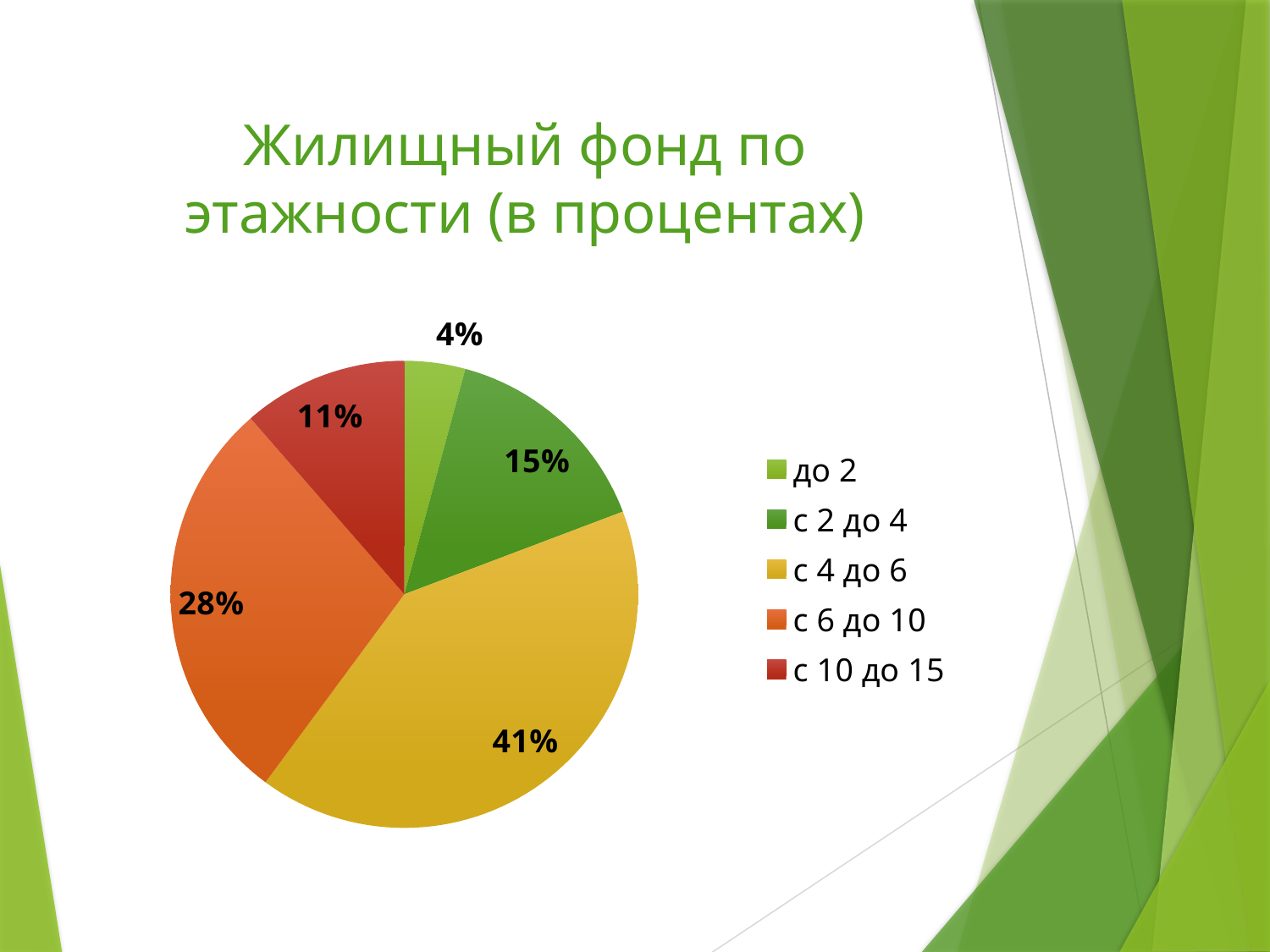
Which category has the smallest share of the pie? до 2 What colour is the "с 6 до 10" slice? orange What kind of chart is shown on the slide? pie chart What is the difference between the "с 4 до 6" and "с 6 до 10" slices? 13% Which category has the largest share of the pie? с 4 до 6 What is the value for the "с 10 до 15" slice? 11% What is the title of the chart? Жилищный фонд по этажности (в процентах) What is the value for the "до 2" slice? 4% How many slices does the pie chart have? 5 What is the value for the "с 6 до 10" slice? 28% What is the value for the "с 4 до 6" slice? 41% Which is larger, the "с 2 до 4" slice or the "с 10 до 15" slice? с 2 до 4